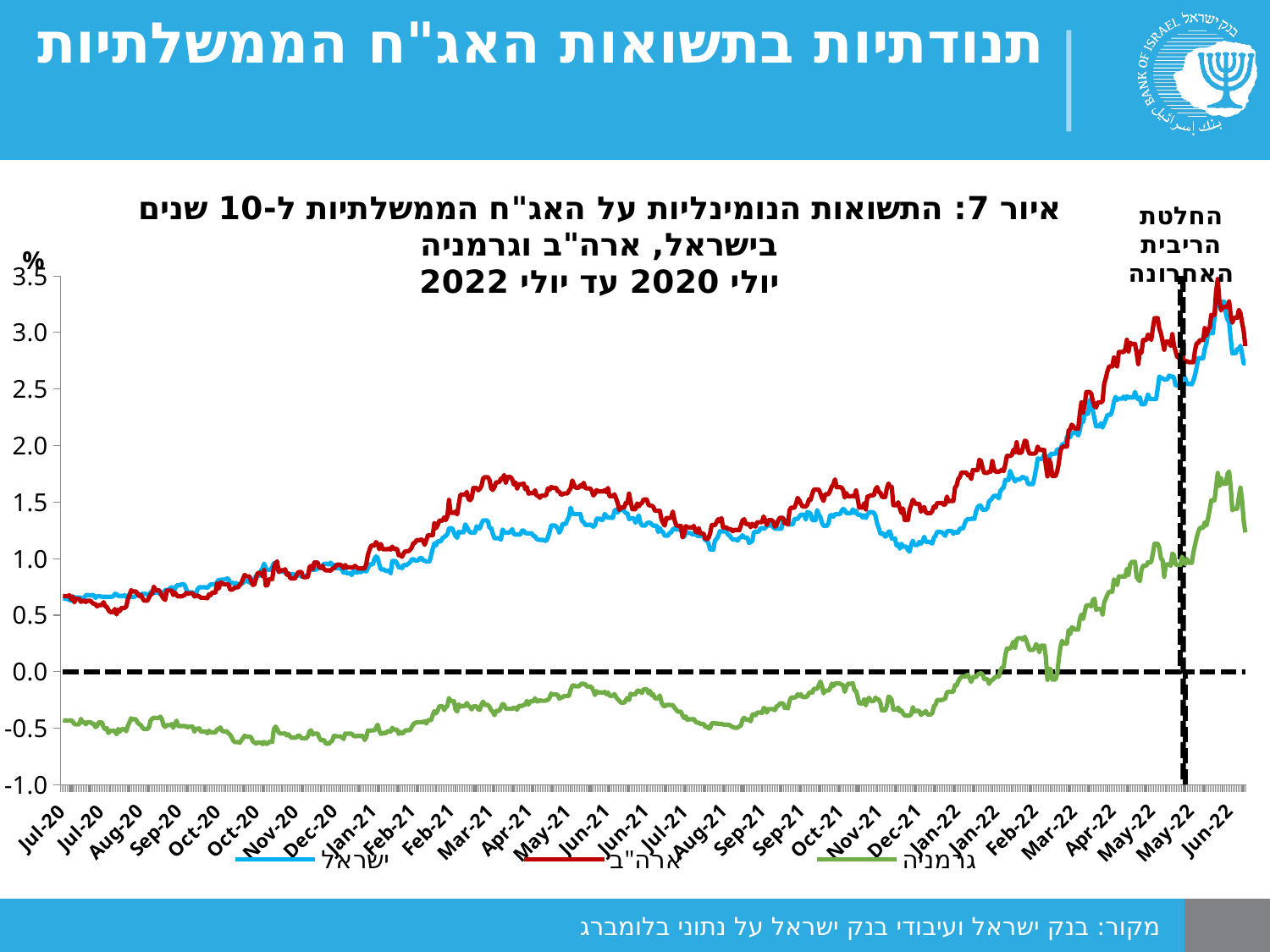
In Jul-20, which is larger: the value for ישראל or the value for גרמניה? ישראל Does the yield for ישראל rise or fall overall from Jul-20 to Jun-22? rise What does the vertical dashed line on the chart mark? החלטת הריבית האחרונה Which series reaches the highest value on the chart? ארה"ב Is the value for ארה"ב in Jun-22 greater or less than 2.0? greater Is the value for גרמניה in Jul-20 greater or less than 0.0? less Which countries are listed in the legend? ישראל, ארה"ב, גרמניה Is the value for גרמניה in May-22 greater or less than 0.5? greater What kind of chart is shown on the slide? line chart Which series has the lowest values throughout the period? גרמניה How many series does the legend list? 3